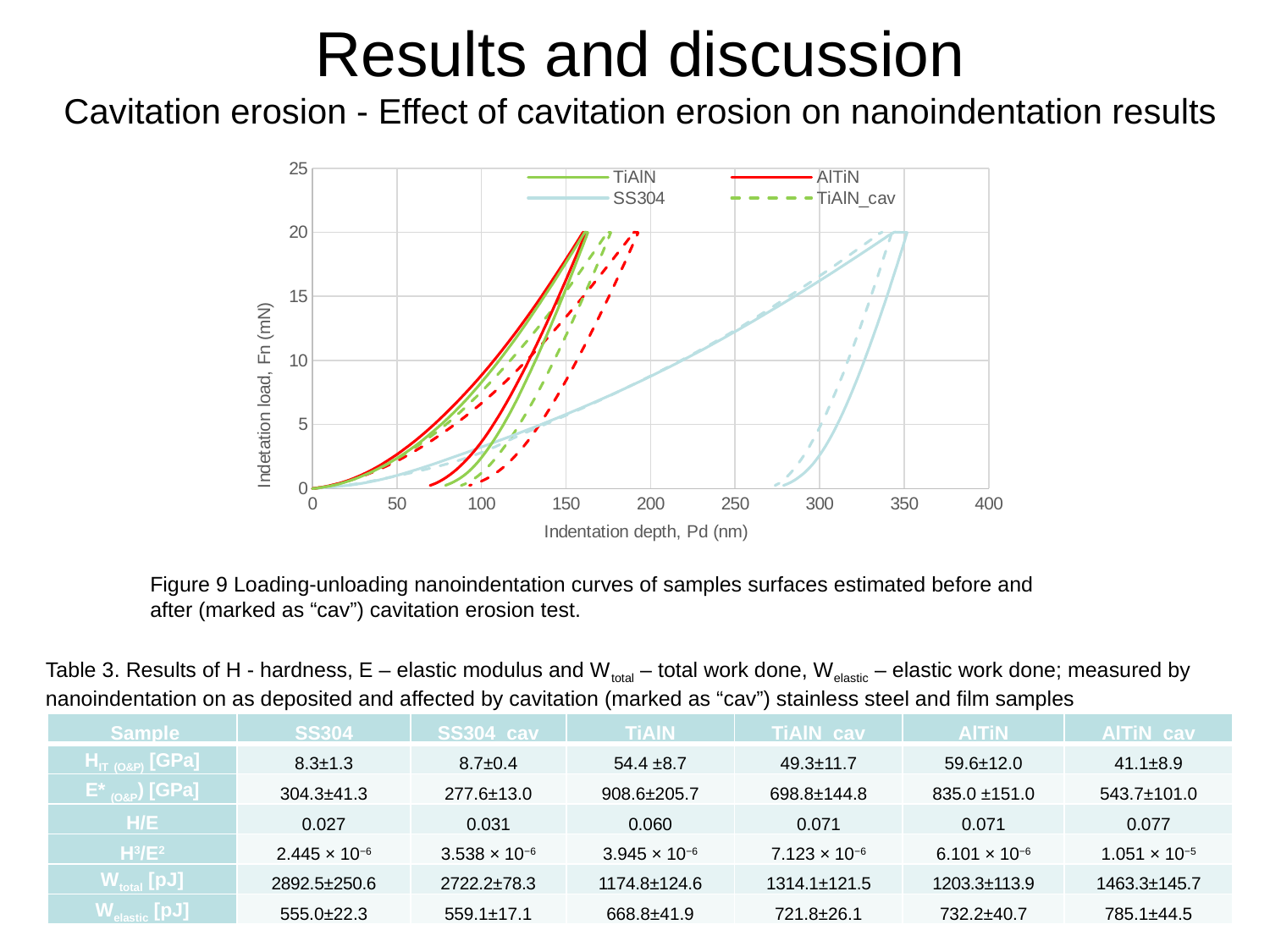
Which reaches a larger indentation depth at 20 mN load, SS304 or TiAlN? SS304 Is the maximum indentation depth reached by the AlTiN curve greater or less than 200 nm? less Along the loading part of the curves, does the indentation load rise or fall as indentation depth increases? rise What is the maximum indentation load (mN) reached by the curves in the chart? 20 What is the label of the x axis of the chart? Indentation depth, Pd (nm) Is the maximum indentation depth reached by the SS304 curve greater or less than 300 nm? greater Is the maximum indentation depth reached by the TiAlN curve greater or less than 200 nm? less What is the highest value shown on the x axis of the chart? 400 What is the label of the y axis of the chart? Indetation load, Fn (mN) Which series in the chart reaches the largest indentation depth? SS304 What kind of chart is shown on the slide? line chart How many series does the chart legend list? 4